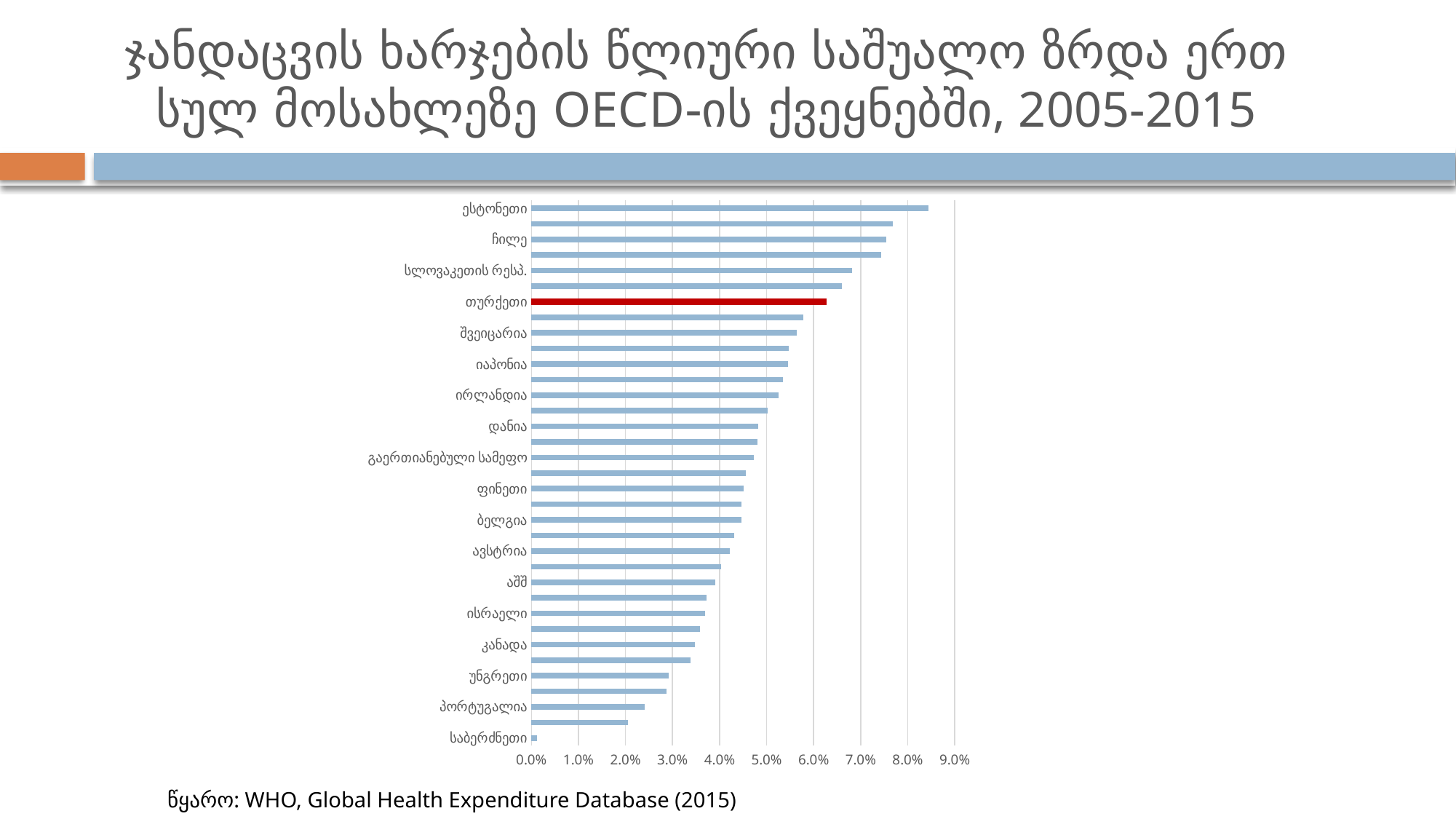
Which has the larger value, ჩილე or თურქეთი? ჩილე Is the value for კანადა greater or less than 4.0%? less Which country's bar is highlighted in red? თურქეთი Is the value for იაპონია greater or less than 5.0%? greater Is the value for საბერძნეთი greater or less than 1.0%? less Which country has the highest value in the chart? ესტონეთი What kind of chart is shown on the slide? bar chart Do the bar values increase or decrease going from the top of the chart to the bottom? decrease Which country has the lowest value in the chart? საბერძნეთი